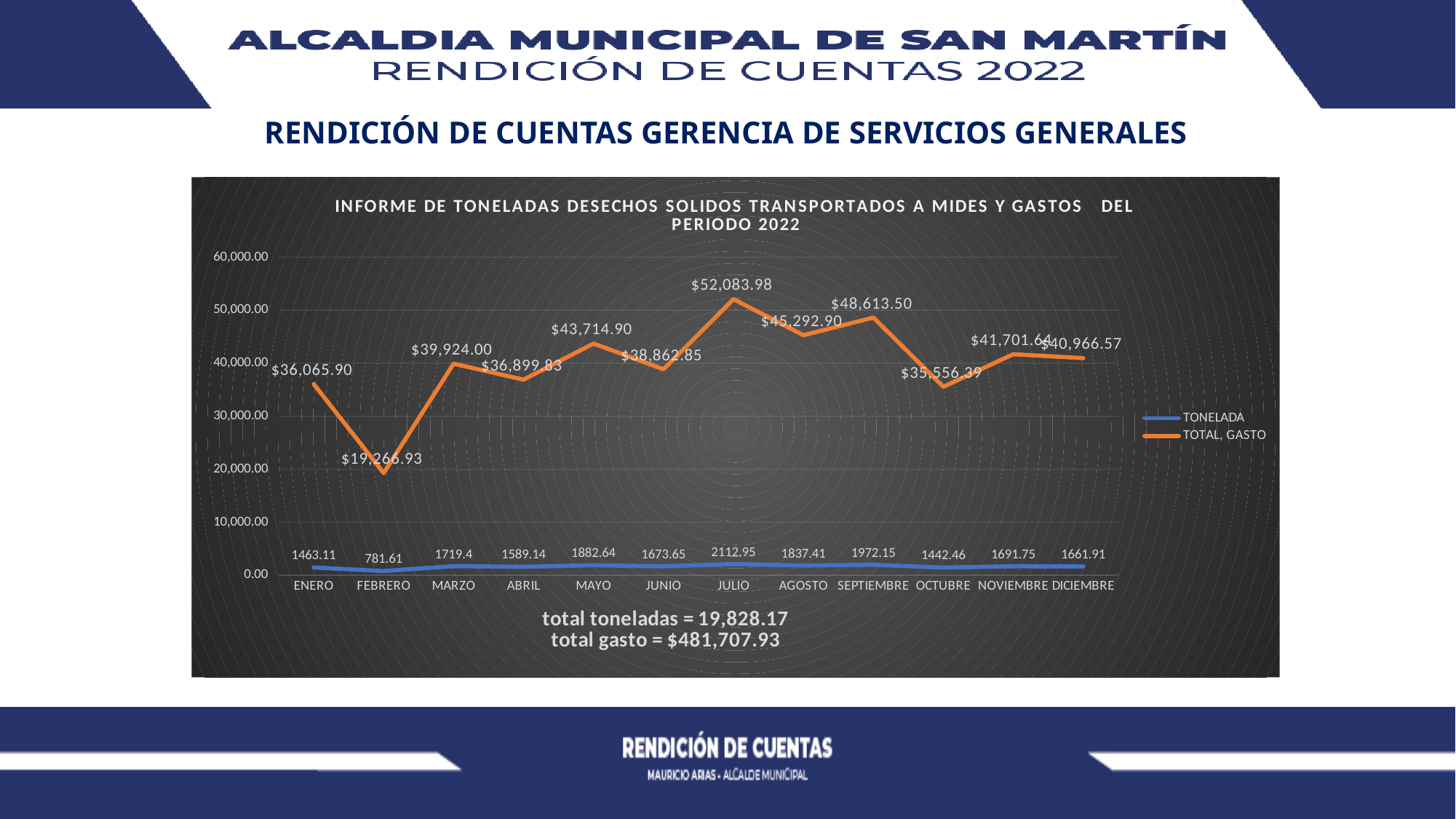
What kind of chart is shown on the slide? line chart Which month has the larger TONELADA value, SEPTIEMBRE or OCTUBRE? SEPTIEMBRE How many months are shown on the x axis of the chart? 12 Is the TOTAL, GASTO value for MAYO greater or less than 40,000.00? greater What is the TONELADA value for MAYO? 1882.64 Which month has the highest TOTAL, GASTO value? JULIO How many series does the chart legend list? 2 What is the TOTAL, GASTO value for FEBRERO? $19,266.93 What is the difference between the TOTAL, GASTO values for JULIO and FEBRERO? $32,817.05 What total gasto is stated below the chart? $481,707.93 What is the TOTAL, GASTO value for JULIO? $52,083.98 Which month has the lowest TONELADA value? FEBRERO